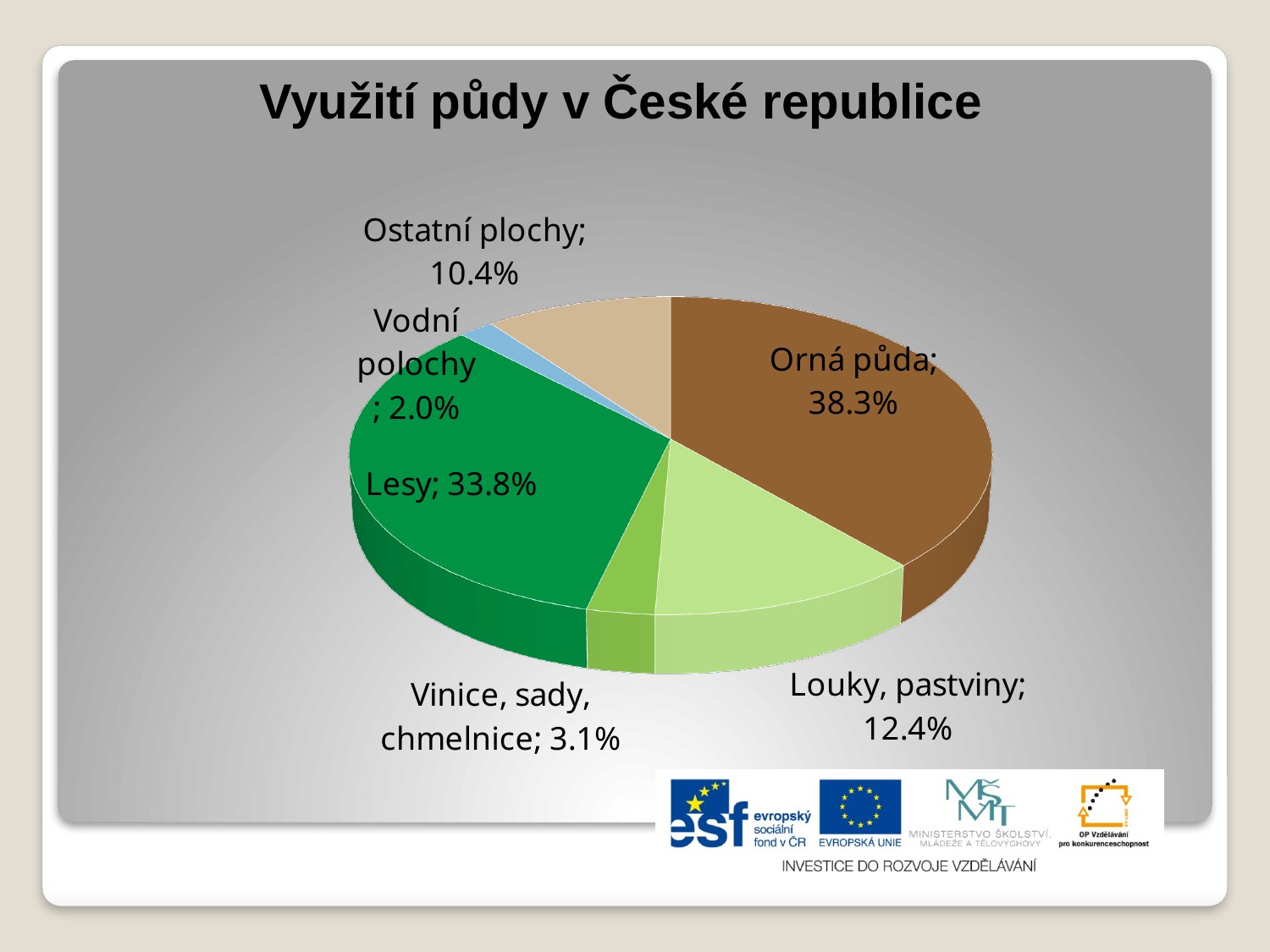
What is the difference between the values for Vinice, sady, chmelnice and Vodní polochy? 1.1% What is the difference between the values for Orná půda and Lesy? 4.5% What is the title of the chart? Využití půdy v České republice Which category has the largest slice of the pie? Orná půda What share of the pie does Orná půda have? 38.3% What type of chart is shown on the slide? pie chart How many slices does the pie chart have? 6 What is the value shown for Louky, pastviny? 12.4% Which is larger, Ostatní plochy or Louky, pastviny? Louky, pastviny Which category has the smallest slice of the pie? Vodní polochy What is the value shown for Vodní polochy? 2.0% What is the value shown for Lesy? 33.8%